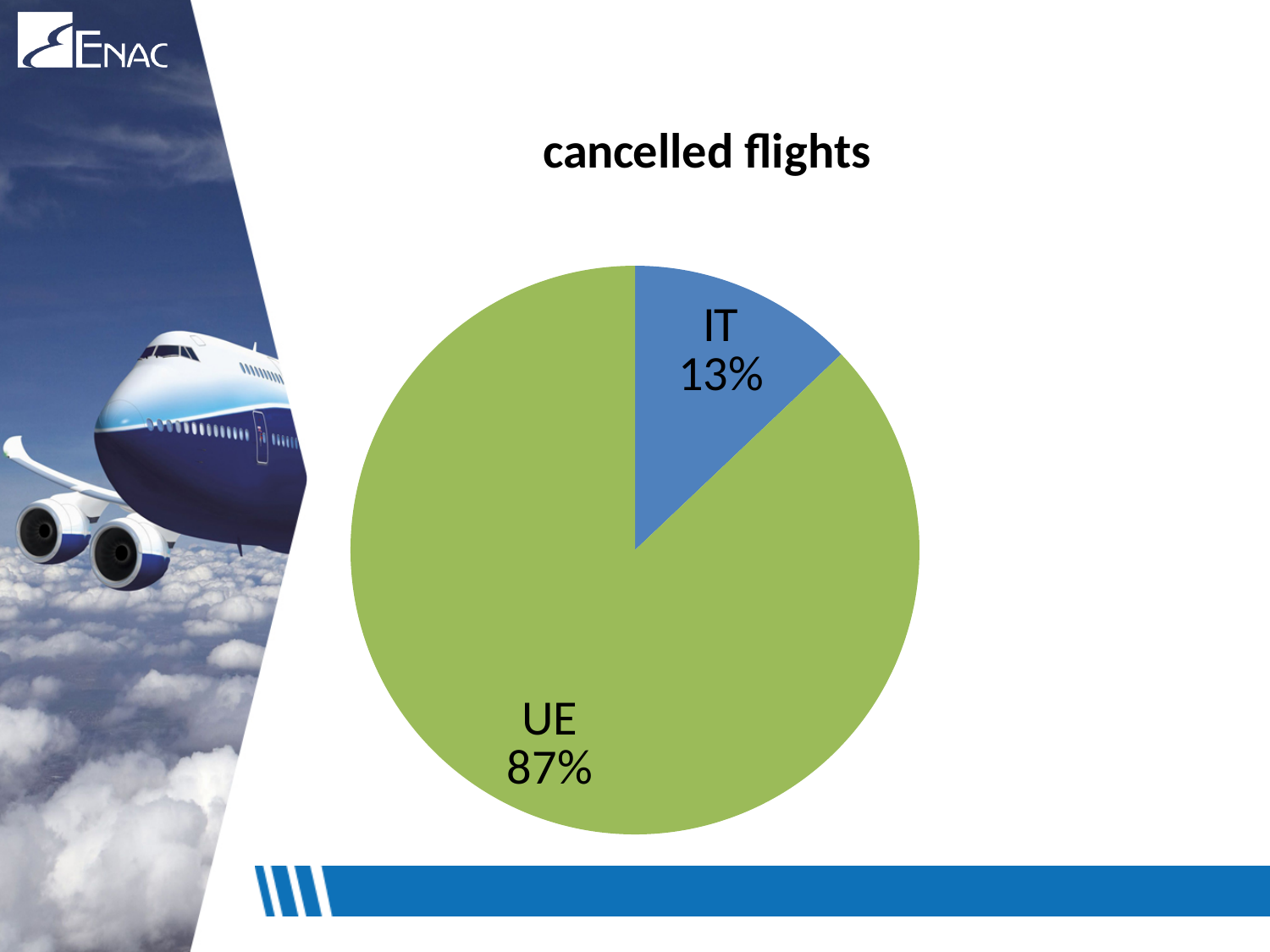
What kind of chart is shown on the slide? Pie chart What is the difference in percentage points between the UE and IT shares? 74 What colour is the UE slice? Green What share of cancelled flights does the UE slice represent? 87% What is the title of the chart? cancelled flights How many slices does the pie chart have? 2 Which is larger, the IT share or the UE share? UE Which category has the smallest share of cancelled flights? IT What share of cancelled flights does the IT slice represent? 13% Which category has the largest share of cancelled flights? UE